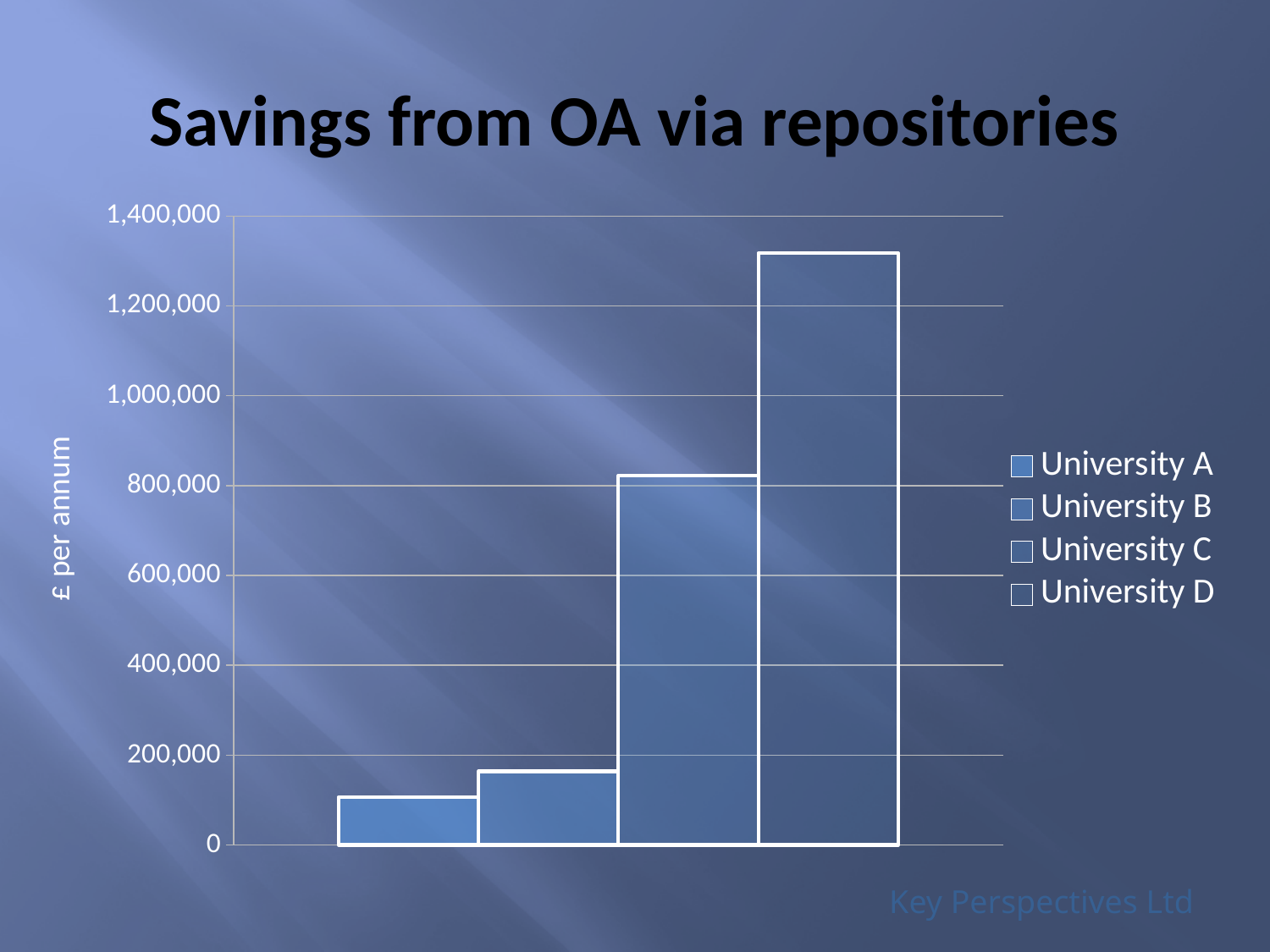
Is the value for University C greater or less than 800,000? greater How many series does the legend list? 4 Is the value for University C greater or less than 1,000,000? less Do the bars rise or fall from University A to University D? rise Which is larger, the value for University D or the value for University C? University D Which is larger, the value for University C or the value for University B? University C What kind of chart is shown on the slide? bar chart Which university has the highest savings? University D Which university has the lowest savings? University A What is the title of the chart? Savings from OA via repositories Is the value for University A greater or less than 200,000? less